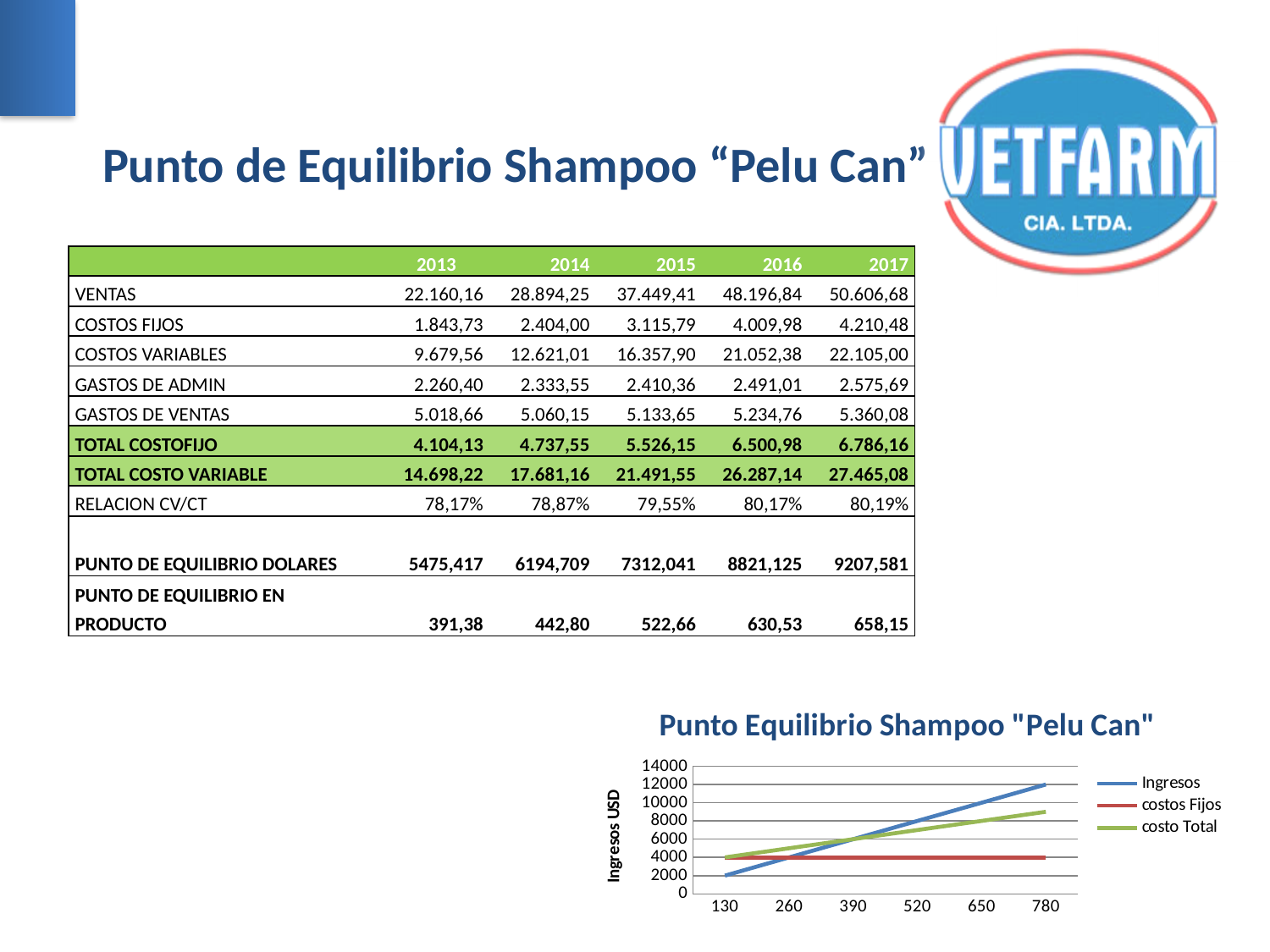
At 780, which series has the larger value, Ingresos or costo Total? Ingresos How many series does the chart legend list? 3 Is the value of costo Total at 780 greater or less than 8000? greater What kind of chart is shown on the slide? line chart What is the label on the y axis of the chart? Ingresos USD Is the value of Ingresos at 780 greater or less than 10000? greater What is the title of the chart? Punto Equilibrio Shampoo "Pelu Can" How many points are marked along the x axis of the chart? 6 Does the Ingresos line rise or fall as the x-axis values increase from 130 to 780? rise Is the value of Ingresos at 130 greater or less than 4000? less At 130, which series has the larger value, Ingresos or costo Total? costo Total